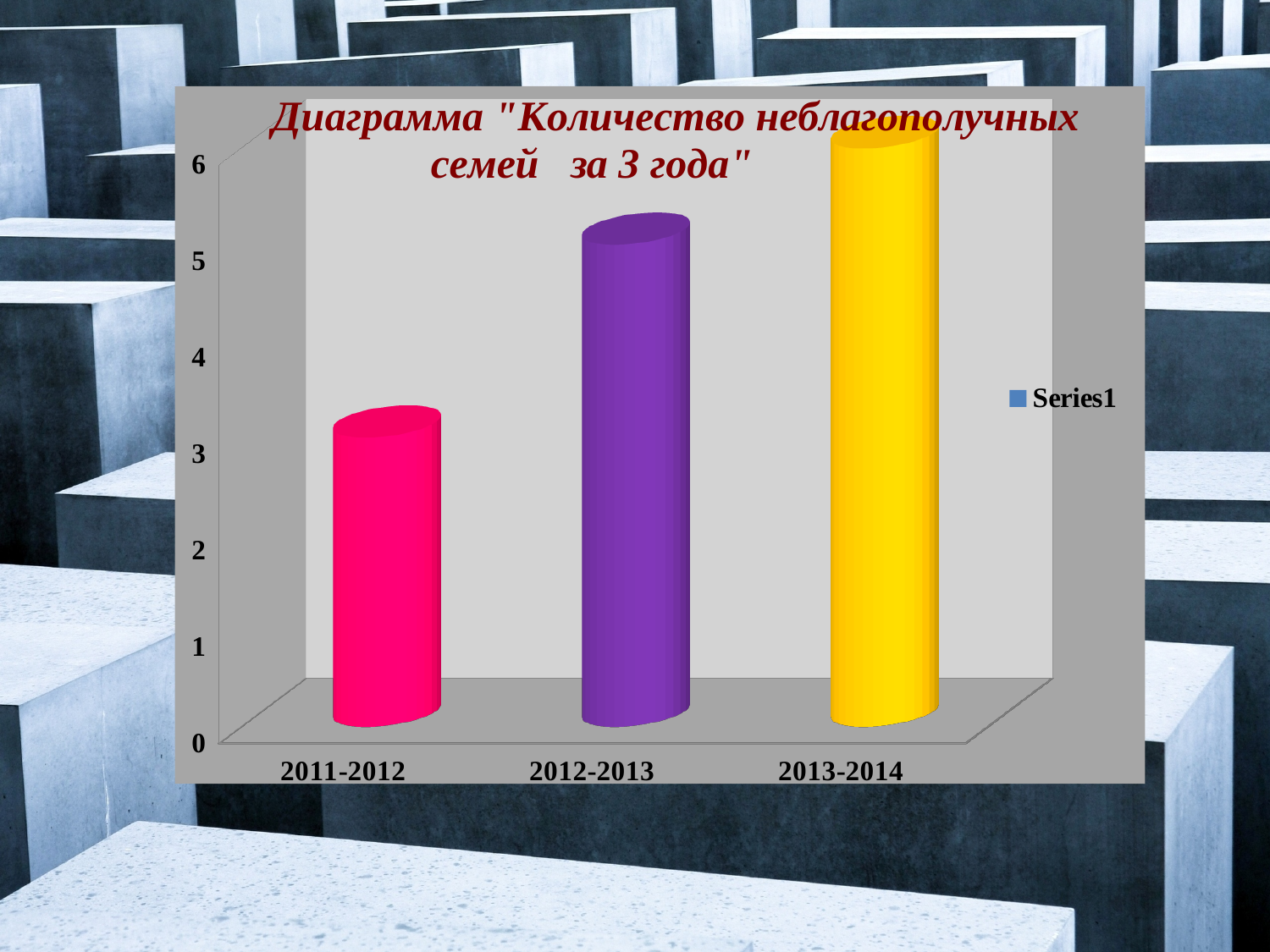
Do the values rise or fall from 2011-2012 to 2013-2014? rise What is the name of the series listed in the legend? Series1 How many categories are shown on the x axis of the chart? 3 Which is larger, the value for 2012-2013 or the value for 2011-2012? 2012-2013 Which category has the lowest bar? 2011-2012 Is the value for 2011-2012 greater or less than 2? greater What kind of chart is shown on the slide? bar chart Is the value for 2012-2013 greater or less than 4? greater Is the value for 2013-2014 greater or less than 5? greater Which category has the highest bar? 2013-2014 How many series does the legend list? 1